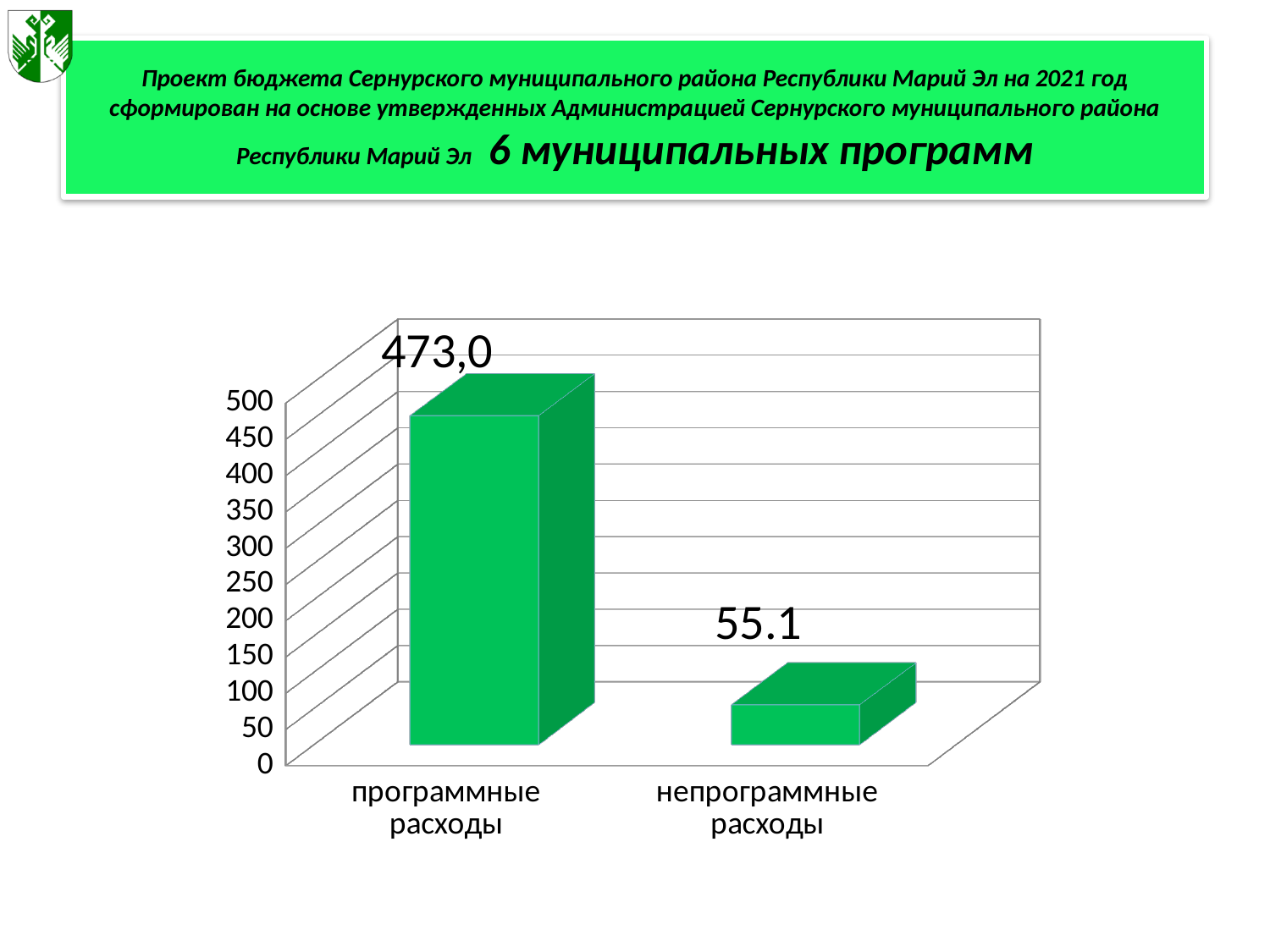
Which category has the lowest value? непрограммные расходы What is the highest tick value shown on the vertical axis? 500 How many categories are shown on the chart? 2 What is the value for программные расходы? 473,0 What colour are the bars in the chart? green Which is larger, программные расходы or непрограммные расходы? программные расходы What is the value for непрограммные расходы? 55.1 Which category has the highest value? программные расходы What kind of chart is shown on the slide? bar chart Is the value for программные расходы greater or less than 400? greater Is the value for непрограммные расходы greater or less than 100? less What is the difference between программные расходы and непрограммные расходы? 417.9